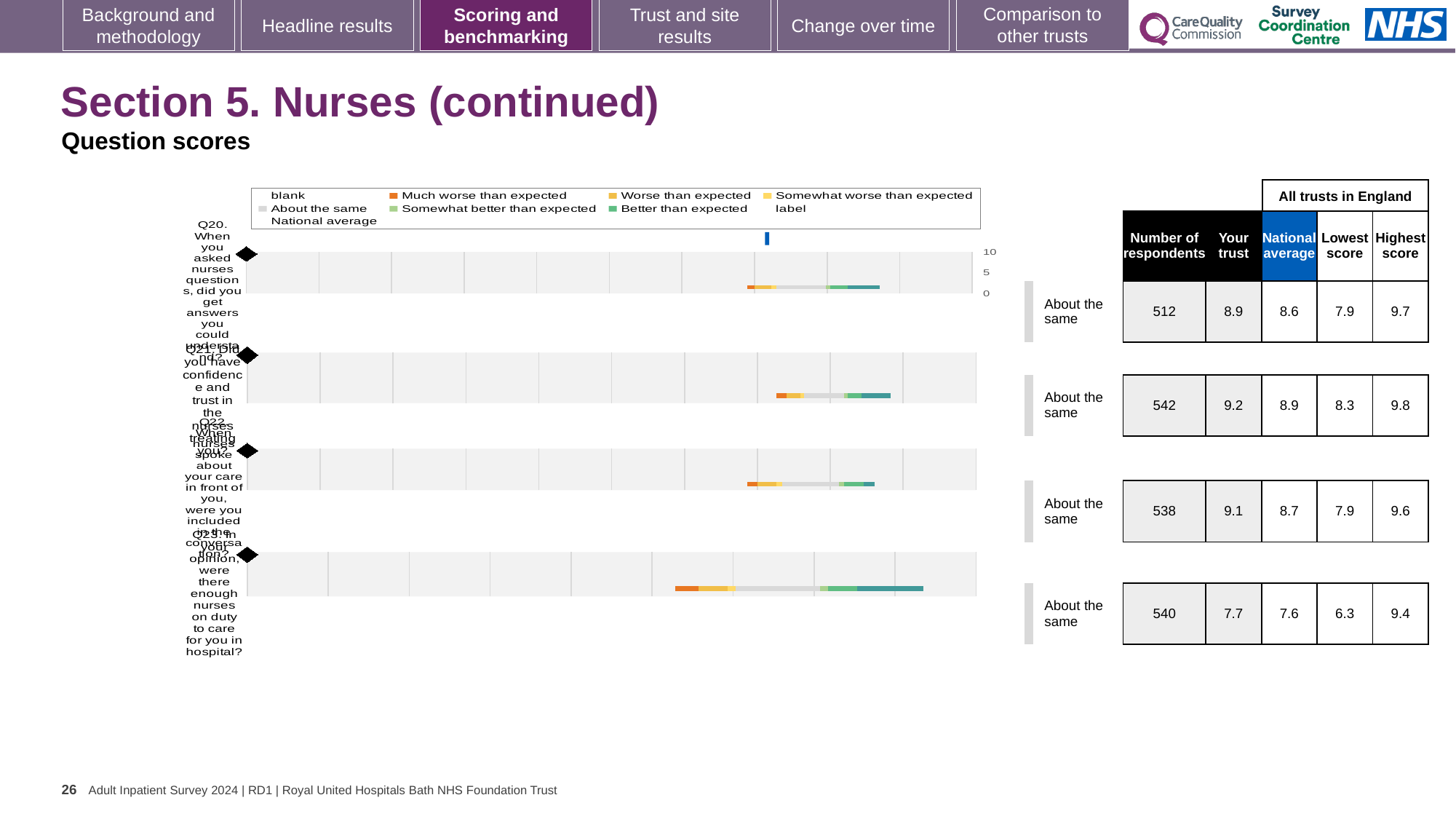
What is the national average score for Q21 (did you have confidence and trust in the nurses treating you)? 8.9 How many survey questions (bars) are plotted in the chart? 4 What is the difference between the 'Your trust' score and the national average for Q21? 0.3 What kind of chart is shown on the slide? bar chart What is the number of respondents for Q20? 512 What benchmark category is shown for Q23? About the same Which question has the lowest 'Your trust' score? Q23 What is the maximum value shown on the chart's score axis? 10 What is the 'Your trust' score for Q23 (were there enough nurses on duty to care for you in hospital)? 7.7 For Q20, which is larger: the 'Your trust' score or the national average? Your trust Which question has the highest 'Your trust' score? Q21 What is the highest score across all trusts in England for Q22? 9.6